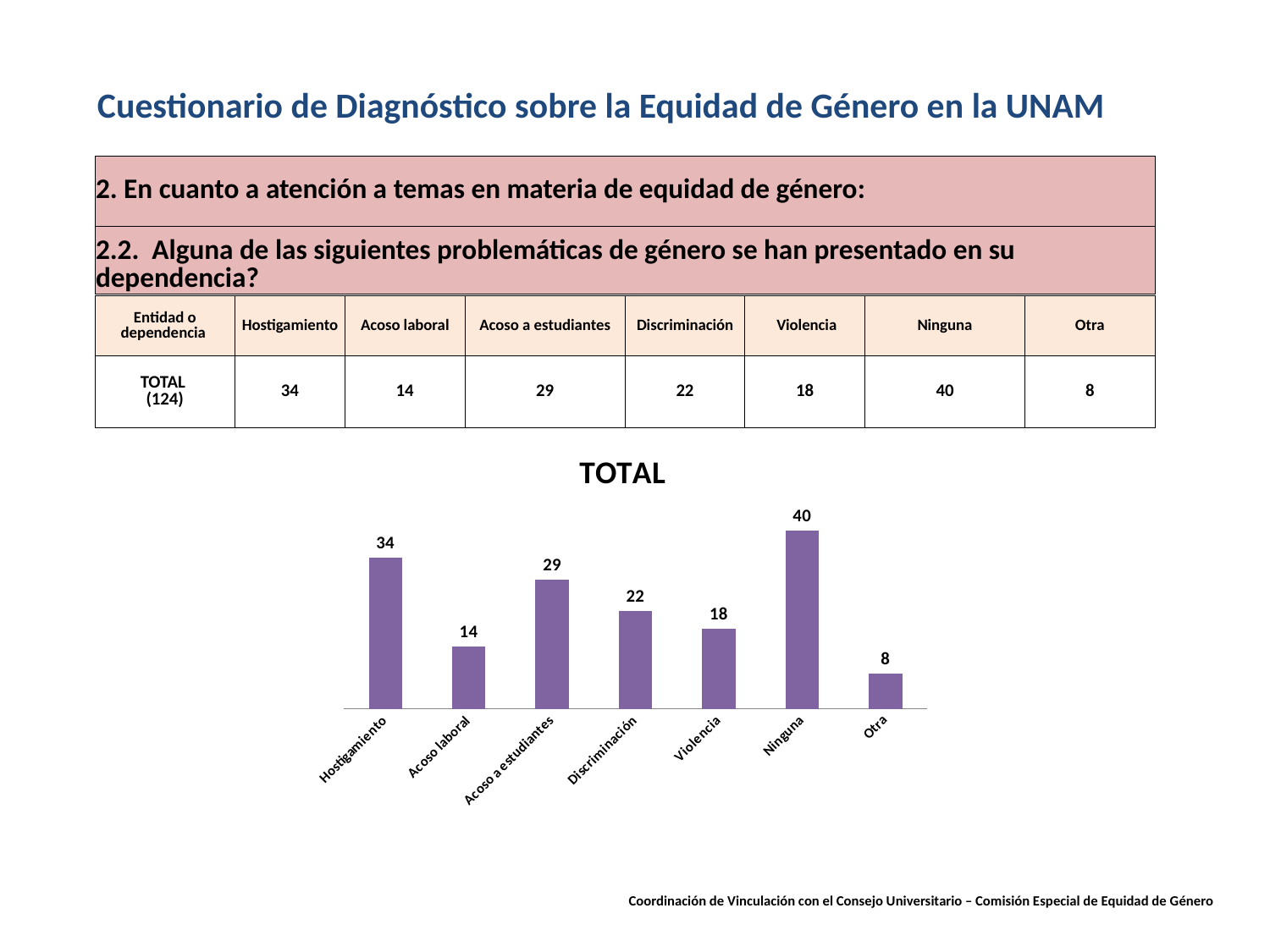
What is the title of the chart on the slide? TOTAL What is the difference between the values for Ninguna and Hostigamiento in the TOTAL chart? 6 What is the value for Hostigamiento in the TOTAL chart? 34 What is the difference between the values for Discriminación and Acoso laboral in the TOTAL chart? 8 Which category has the lowest value in the TOTAL chart? Otra What is the value for Violencia in the TOTAL chart? 18 What is the value for Acoso a estudiantes in the TOTAL chart? 29 Which category has the highest value in the TOTAL chart? Ninguna How many categories are shown in the TOTAL chart? 7 What kind of chart is shown on the slide? Bar chart Which is larger in the TOTAL chart, Acoso laboral or Violencia? Violencia Which is larger in the TOTAL chart, Acoso a estudiantes or Discriminación? Acoso a estudiantes